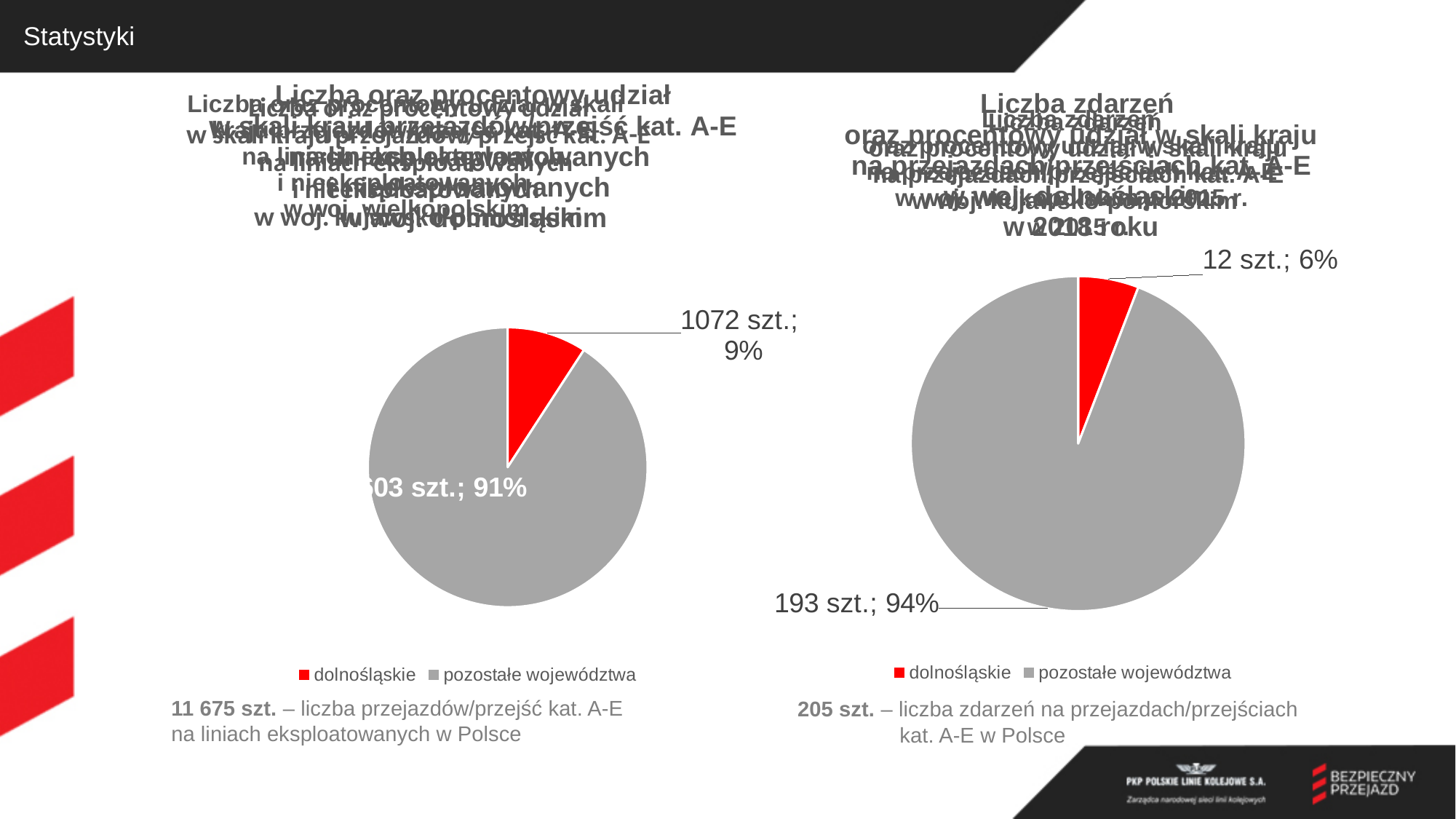
How many entries does the legend of the right chart list? 2 On the right pie chart, what value is shown for dolnośląskie? 12 szt.; 6% On the right pie chart, which category has the largest slice? pozostałe województwa What type of chart is used on the left side of the slide? pie chart On the right pie chart, what value is shown for pozostałe województwa? 193 szt.; 94% On the right pie chart, what is the total count of both slices combined? 205 szt. On the right pie chart, what share of the pie does pozostałe województwa represent? 94% On the left pie chart, which category has the smallest slice? dolnośląskie On the left pie chart, what value is shown for dolnośląskie? 1072 szt.; 9% On the right pie chart, what is the difference in count between pozostałe województwa and dolnośląskie? 181 szt. On the left pie chart, what share of the pie does dolnośląskie represent? 9% On the left pie chart, what colour is used for dolnośląskie? red